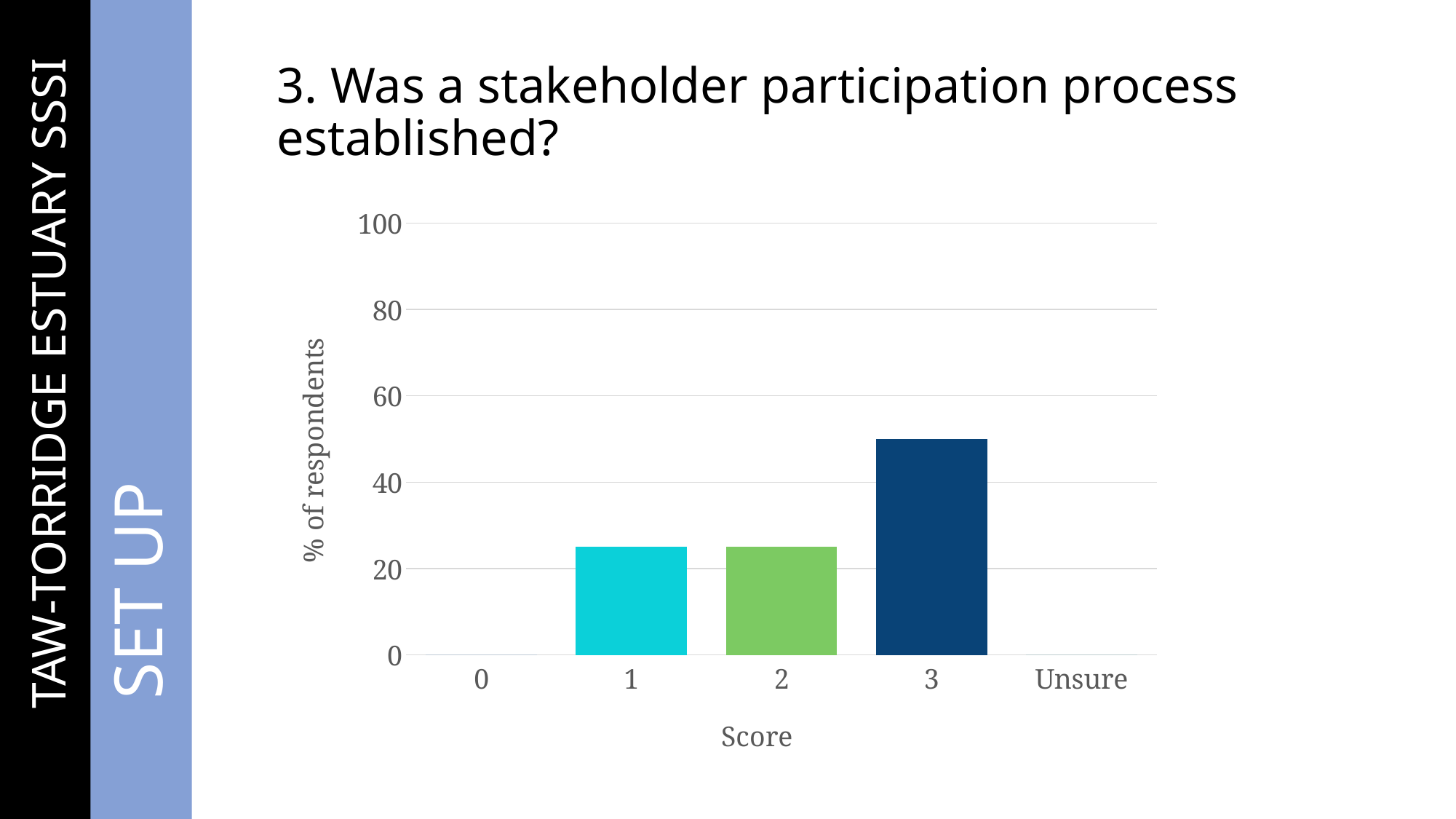
How many score categories are shown on the x axis? 5 What is the label on the y axis of the chart? % of respondents Is the value for score 1 greater or less than 20? greater Which has a higher percentage of respondents, score 3 or score 1? 3 Is the value for score 3 greater or less than 40? greater Is the value for score 3 greater or less than 60? less What is the label on the x axis of the chart? Score Which score category has the highest percentage of respondents? 3 What kind of chart is shown on the slide? bar chart What percentage of respondents gave a score of 0? 0 What percentage of respondents answered Unsure? 0